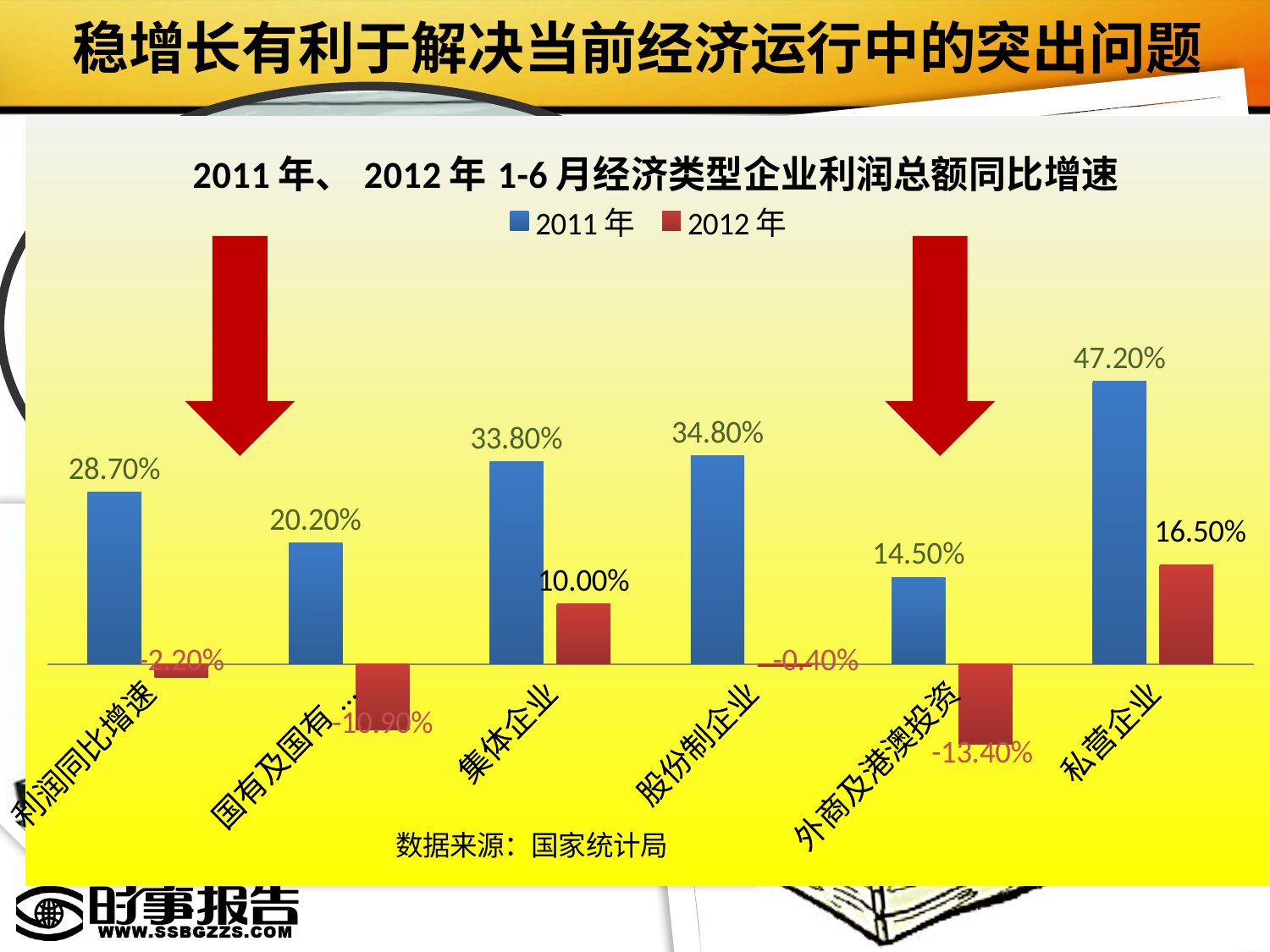
Which category has the lowest 2012年 value? 外商及港澳投资 What is the 2012年 value for 集体企业? 10.00% What is the 2011年 value for 私营企业? 47.20% What is the 2011年 value for 利润同比增速? 28.70% How many categories are shown on the x axis? 6 What kind of chart is shown on the slide? bar chart What is the difference between the 2011年 and 2012年 values for 私营企业? 30.70% What is the 2012年 value for 外商及港澳投资? -13.40% How many series does the legend list? 2 Which has the larger 2011年 value, 集体企业 or 股份制企业? 股份制企业 Which category has the highest 2011年 value? 私营企业 What is the 2012年 value for 股份制企业? -0.40%